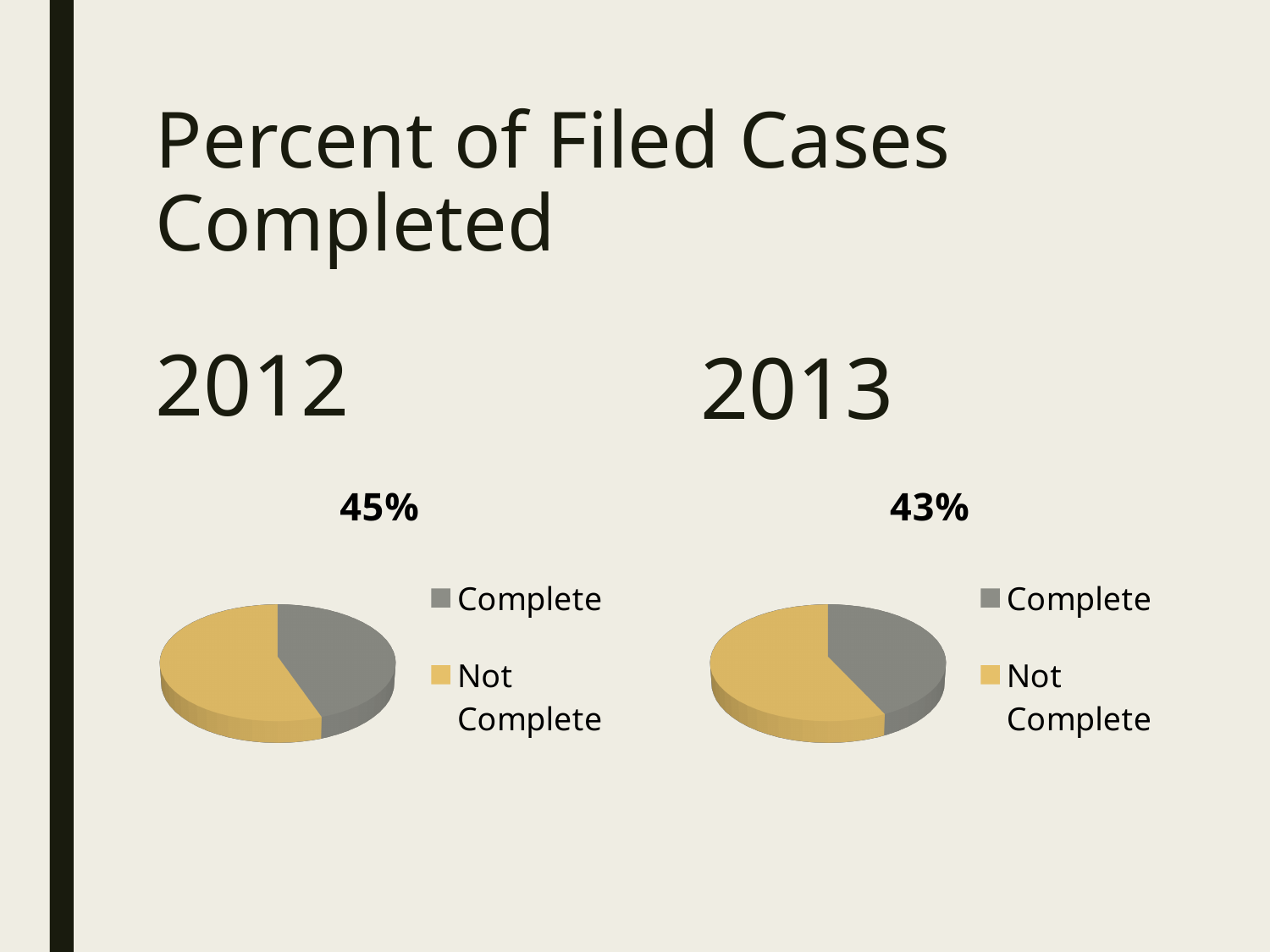
How many entries does the legend of the 2013 pie chart list? 2 What is the title printed above the 2012 pie chart? 45% What is the title printed above the 2013 pie chart? 43% How many slices does the 2012 pie chart have? 2 In the 2012 pie chart, what colour is the Not Complete slice? yellow What is the difference between the 2012 chart title value (45%) and the 2013 chart title value (43%)? 2% What kind of chart is shown under the 2012 heading? pie chart In the 2012 pie chart, which slice is larger, Complete or Not Complete? Not Complete In the 2013 pie chart, which slice is the largest? Not Complete Which chart title is larger, the 2012 chart's or the 2013 chart's? 2012 What kind of chart is shown under the 2013 heading? pie chart In the 2013 pie chart, which slice is the smallest? Complete